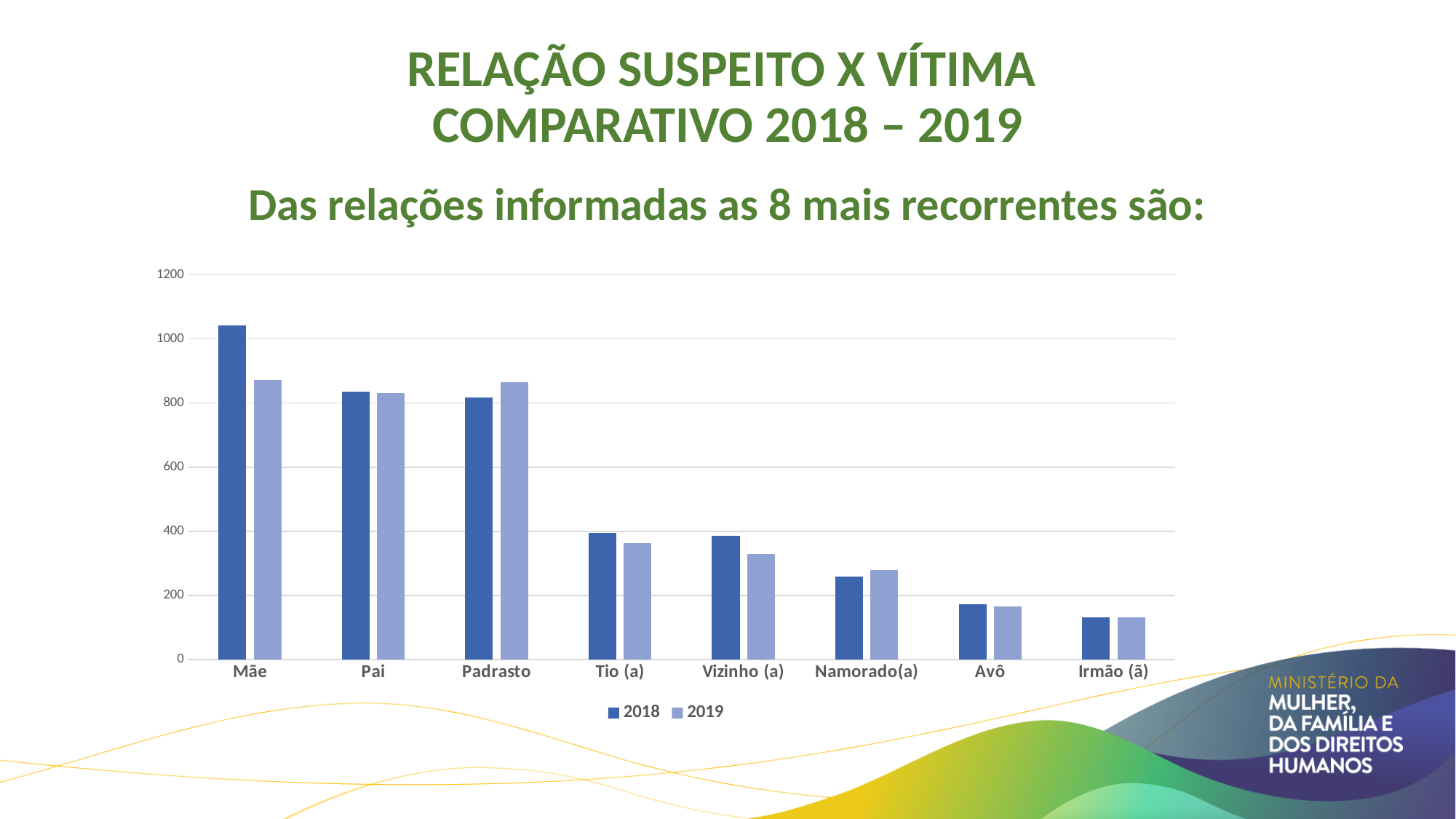
Which category has the highest value for 2018? Mãe Is the 2018 value for Mãe greater or less than 1000? greater For Padrasto, which year has the larger value, 2018 or 2019? 2019 Which category has the lowest value for 2018? Irmão (ã) For Mãe, which year has the larger value, 2018 or 2019? 2018 How many relationship categories are shown on the x axis of the chart? 8 Do the 2018 values generally rise or fall moving from left to right along the x axis? fall Is the 2019 value for Vizinho (a) greater or less than 400? less How many series does the chart's legend list? 2 Which category has the lowest value for 2019? Irmão (ã) Is the 2019 value for Mãe greater or less than 1000? less What kind of chart is shown on the slide? bar chart